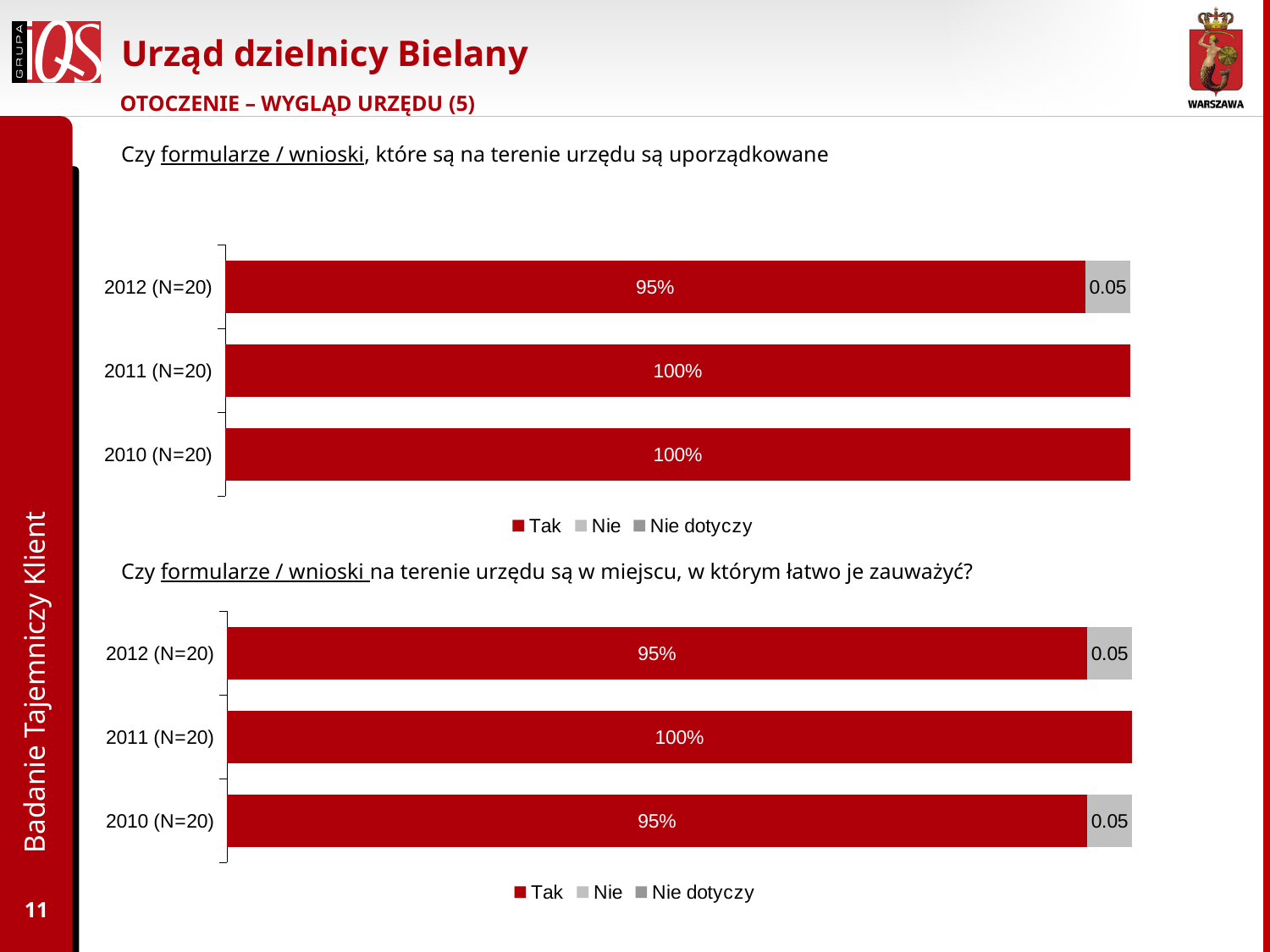
In the bottom chart, is the "Tak" value for 2011 (N=20) larger or smaller than for 2012 (N=20)? larger What type of chart is the top chart? bar chart How many series does the legend of the bottom chart list? 3 How many year categories are shown in the top chart? 3 In the top chart ("Czy formularze / wnioski, które są na terenie urzędu są uporządkowane"), what is the "Tak" value for 2012 (N=20)? 95% In the bottom chart ("Czy formularze / wnioski na terenie urzędu są w miejscu, w którym łatwo je zauważyć?"), what is the "Tak" value for 2010 (N=20)? 95% In the bottom chart, what label is printed on the grey segment for 2010 (N=20)? 0.05 In the top chart, which year has the lowest "Tak" value? 2012 (N=20) In the bottom chart, what is the "Tak" value for 2011 (N=20)? 100% In the top chart, what is the "Tak" value for 2011 (N=20)? 100% In the bottom chart, which year has the highest "Tak" value? 2011 (N=20) In the top chart, what label is printed on the grey "Nie" segment for 2012 (N=20)? 0.05